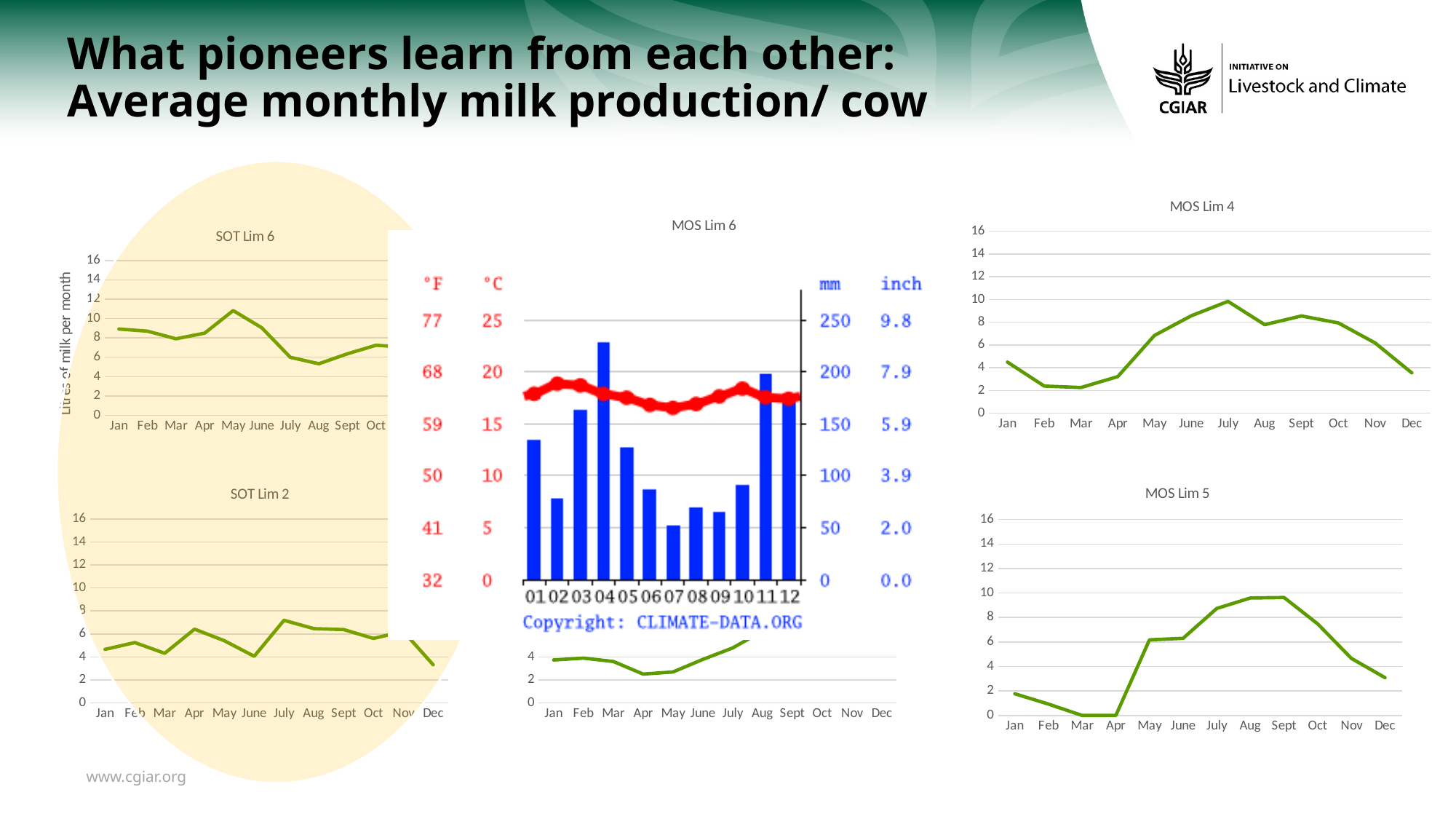
In the SOT Lim 6 chart, is the value for May greater or less than 10? greater In the SOT Lim 6 chart, which of the visible months has the highest value? May In the MOS Lim 6 chart, is the value for Apr greater or less than 4? less In the MOS Lim 5 chart, is the value for Mar greater or less than 2? less How many months are shown on the x axis of the MOS Lim 4 chart? 12 In the SOT Lim 2 chart, which month has the highest value? July In the MOS Lim 5 chart, do the values rise or fall from Apr to Aug? rise In the SOT Lim 2 chart, which month has the lowest value? Dec In the MOS Lim 4 chart, which month has the highest milk production? July In the SOT Lim 2 chart, which is larger, the value for Apr or the value for June? Apr